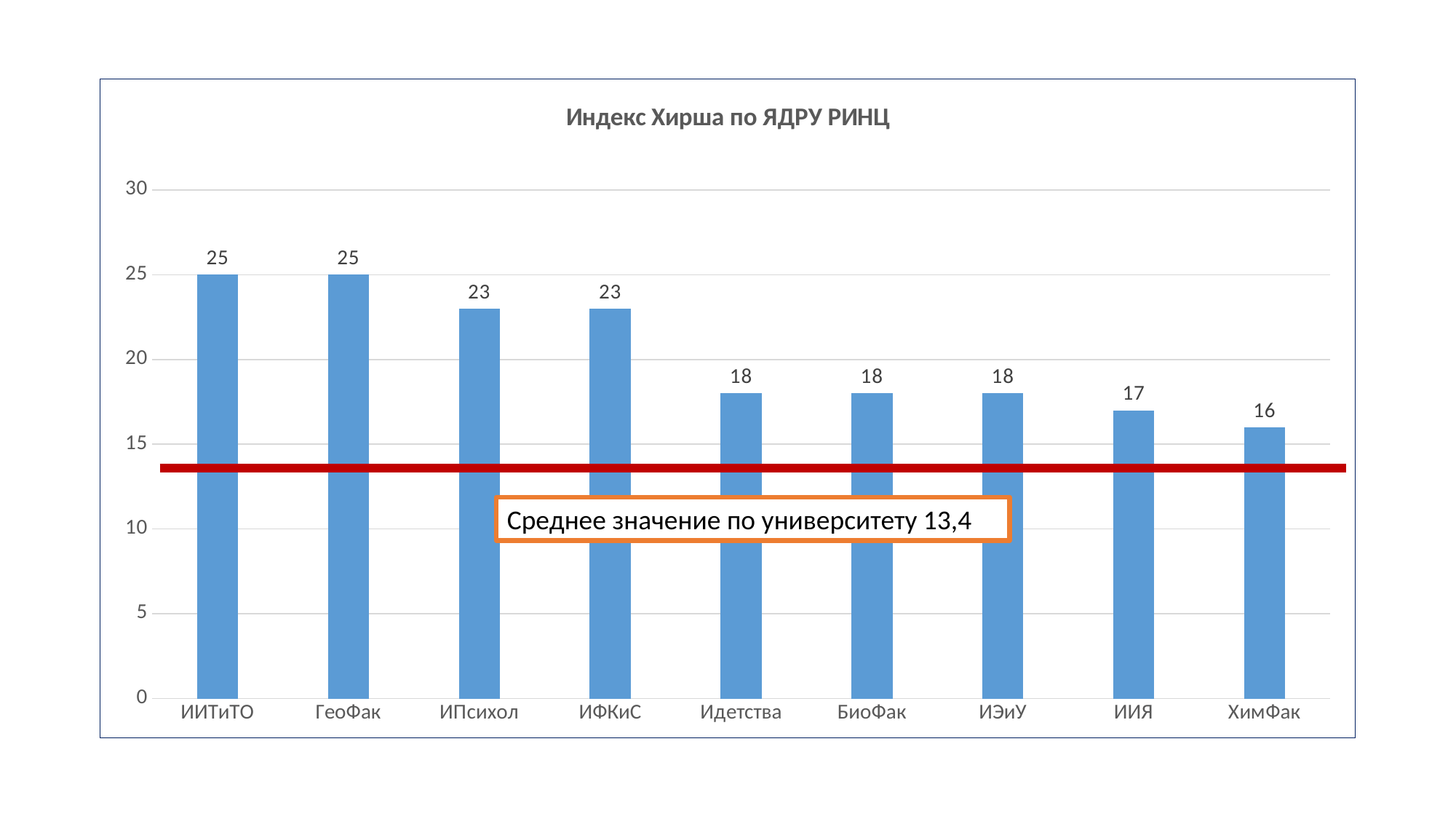
What kind of chart is this? Bar chart What is the difference between the values for ИИТиТО and ХимФак? 9 How many categories are shown on the x axis? 9 Which category has the lowest value? ХимФак What is the title of the chart? Индекс Хирша по ЯДРУ РИНЦ Do the values rise or fall from left to right along the x axis? Fall Which is larger, the value for ГеоФак or the value for Идетства? ГеоФак What is the value for ИИЯ? 17 What is the difference between the values for ИФКиС and ИИЯ? 6 What is the value for ХимФак? 16 What is the value for БиоФак? 18 What is the value for ИПсихол? 23